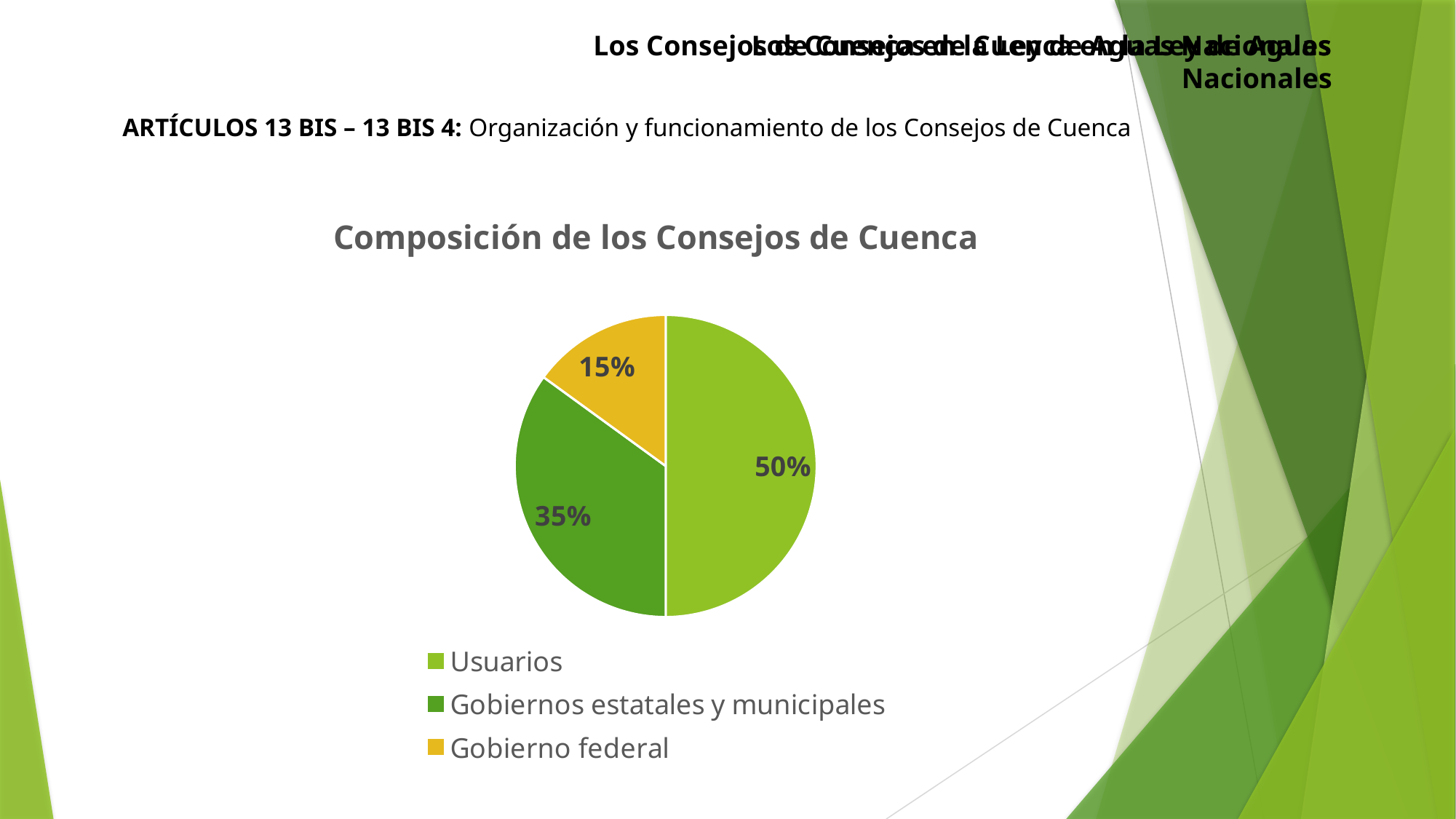
What share of the pie does Usuarios represent? 50% Which is larger, the share for Gobiernos estatales y municipales or the share for Gobierno federal? Gobiernos estatales y municipales What colour is the slice for Gobierno federal? yellow Which category has the largest slice of the pie? Usuarios What is the difference in percentage points between Gobiernos estatales y municipales and Gobierno federal? 20 Which category has the smallest slice of the pie? Gobierno federal What share of the pie does Gobiernos estatales y municipales represent? 35% What is the title of the chart? Composición de los Consejos de Cuenca What kind of chart is shown on the slide? pie chart How many categories does the pie chart show? 3 What is the difference in percentage points between Usuarios and Gobierno federal? 35 What share of the pie does Gobierno federal represent? 15%